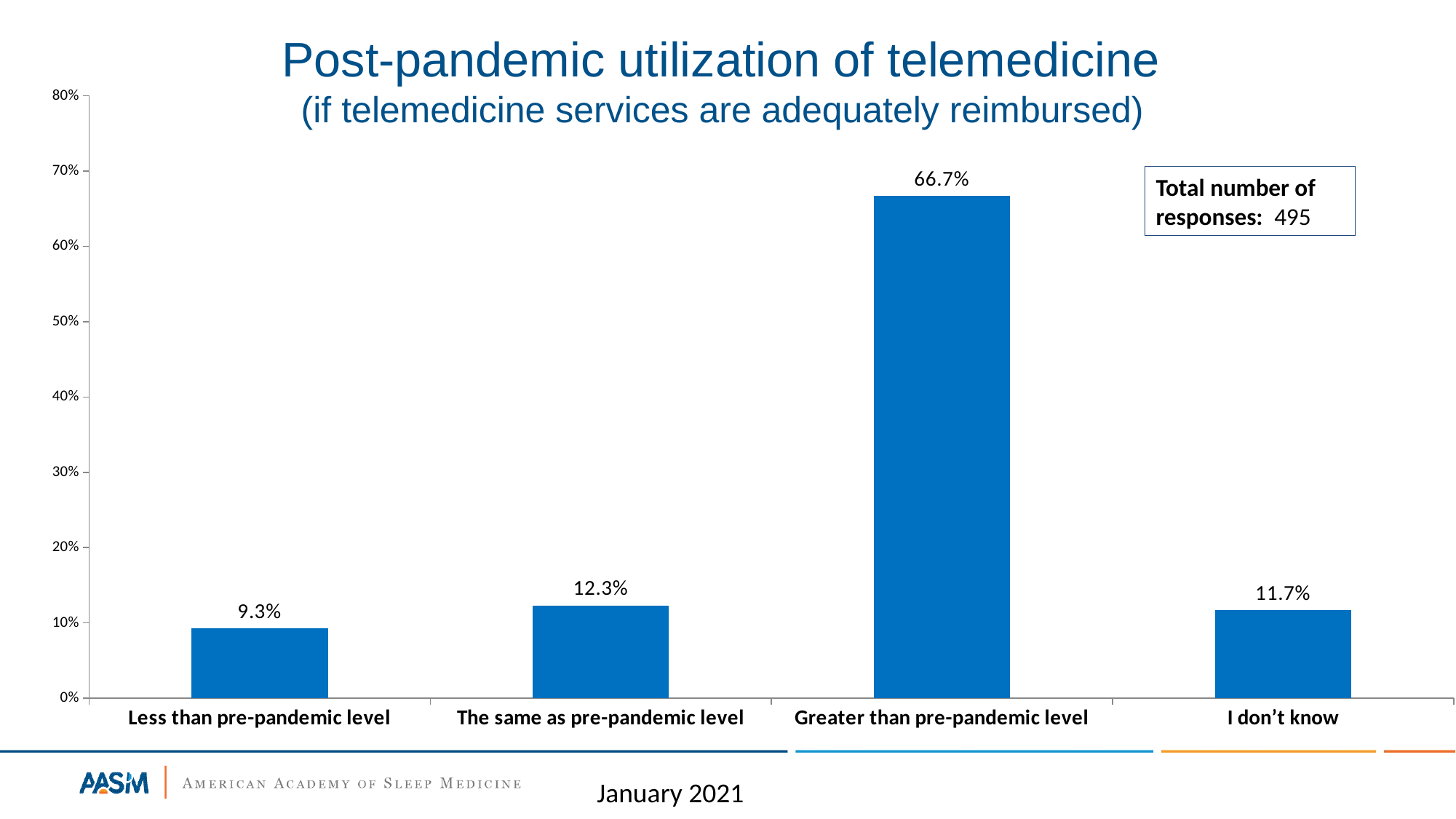
What percentage of respondents expect post-pandemic telemedicine utilization to be greater than pre-pandemic level? 66.7% What kind of chart is shown on the slide? Bar chart Which category has the lowest value? Less than pre-pandemic level Which category has the highest value? Greater than pre-pandemic level Is the value for 'Greater than pre-pandemic level' greater or less than 60%? greater What is the value for 'I don't know'? 11.7% Which is larger, the value for 'The same as pre-pandemic level' or the value for 'I don't know'? The same as pre-pandemic level What is the difference between 'Greater than pre-pandemic level' and 'The same as pre-pandemic level'? 54.4% What is the value for 'Less than pre-pandemic level'? 9.3% How many categories are shown on the x axis? 4 What is the difference between 'The same as pre-pandemic level' and 'Less than pre-pandemic level'? 3.0% What is the total number of responses stated on the slide? 495